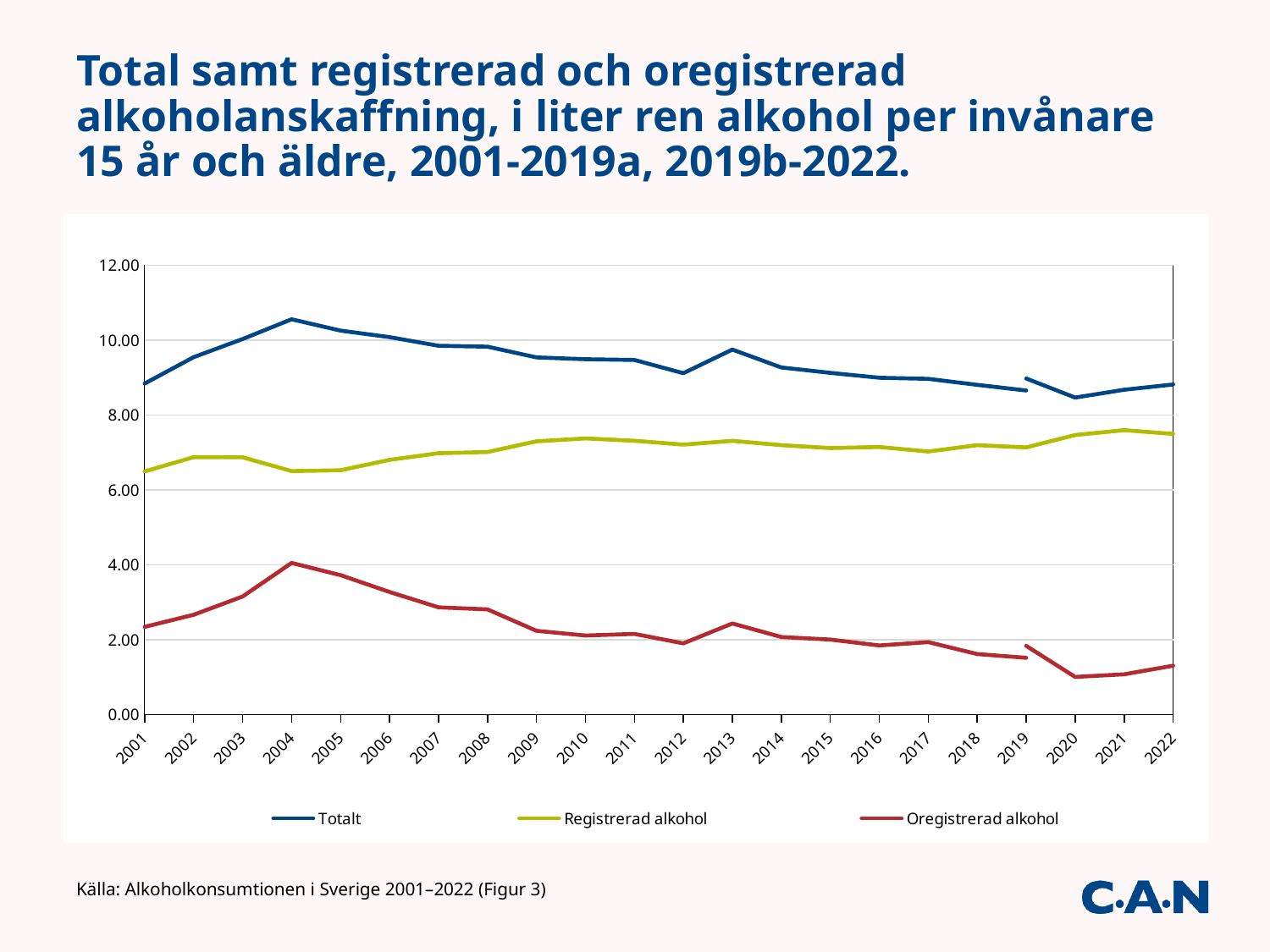
Is the value for Oregistrerad alkohol in 2020 greater or less than 2.00? less Which is larger in 2010, Registrerad alkohol or Oregistrerad alkohol? Registrerad alkohol What kind of chart is shown on the slide? line chart In which year is the Oregistrerad alkohol series at its lowest? 2020 Which series is drawn in red? Oregistrerad alkohol How many series does the legend list? 3 In which year does the Totalt series reach its highest value? 2004 How many years are shown on the x axis? 22 Does the Totalt series rise or fall overall between 2004 and 2022? fall Is the value for Totalt in 2004 greater or less than 10.00? greater Is the value for Registrerad alkohol in 2001 greater or less than 6.00? greater Does the Oregistrerad alkohol series rise or fall between 2004 and 2012? fall